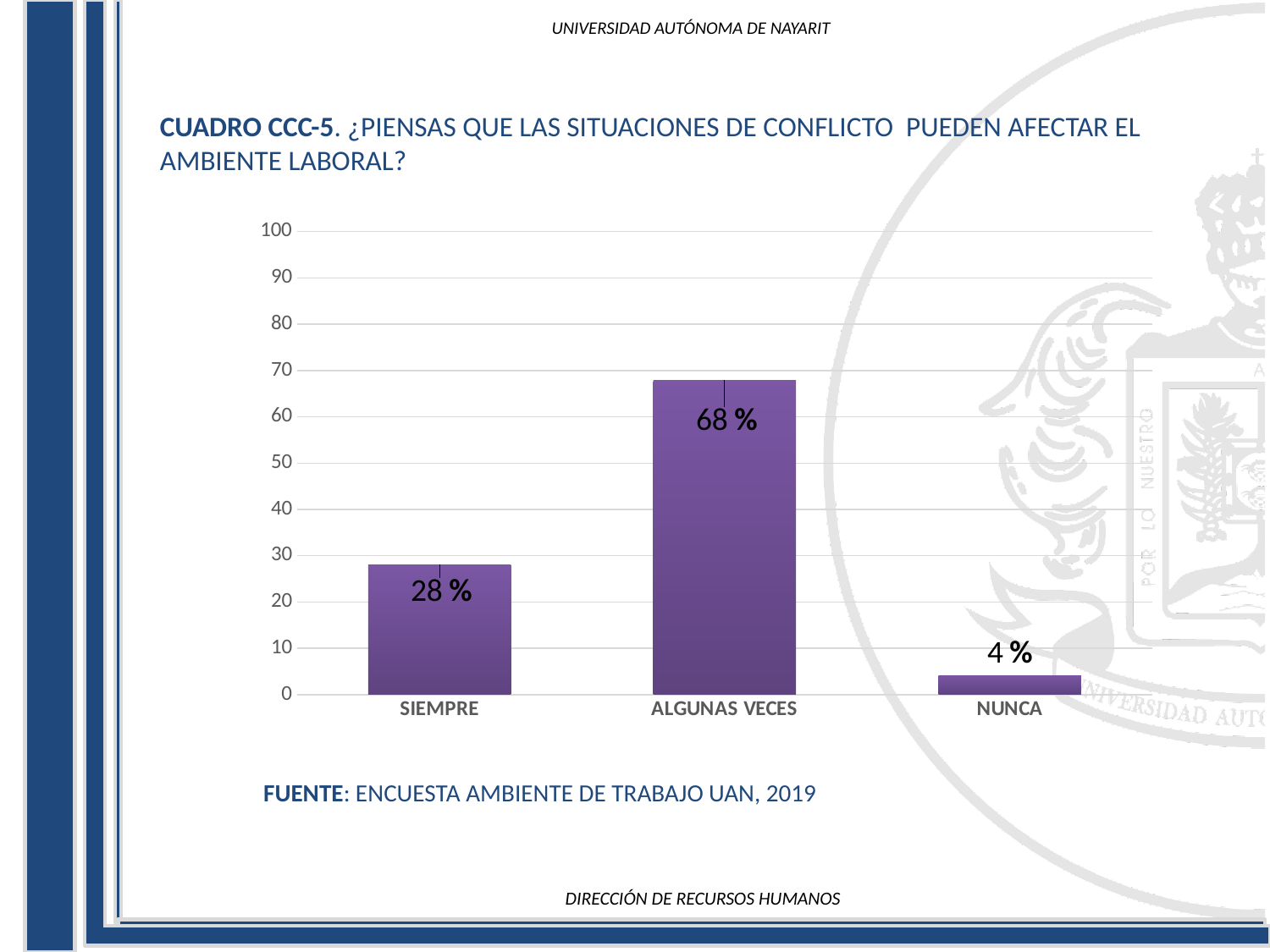
What is the difference between the values for SIEMPRE and NUNCA? 24 % What is the difference between the values for ALGUNAS VECES and SIEMPRE? 40 % What is the value for ALGUNAS VECES? 68 % Which is larger, the value for SIEMPRE or the value for NUNCA? SIEMPRE How many categories are shown on the x axis? 3 What is the value for NUNCA? 4 % What is the source cited below the chart? ENCUESTA AMBIENTE DE TRABAJO UAN, 2019 Which category has the highest value? ALGUNAS VECES What is the value for SIEMPRE? 28 % Is the value for ALGUNAS VECES greater or less than 60? greater Which category has the lowest value? NUNCA What kind of chart is shown on the slide? bar chart